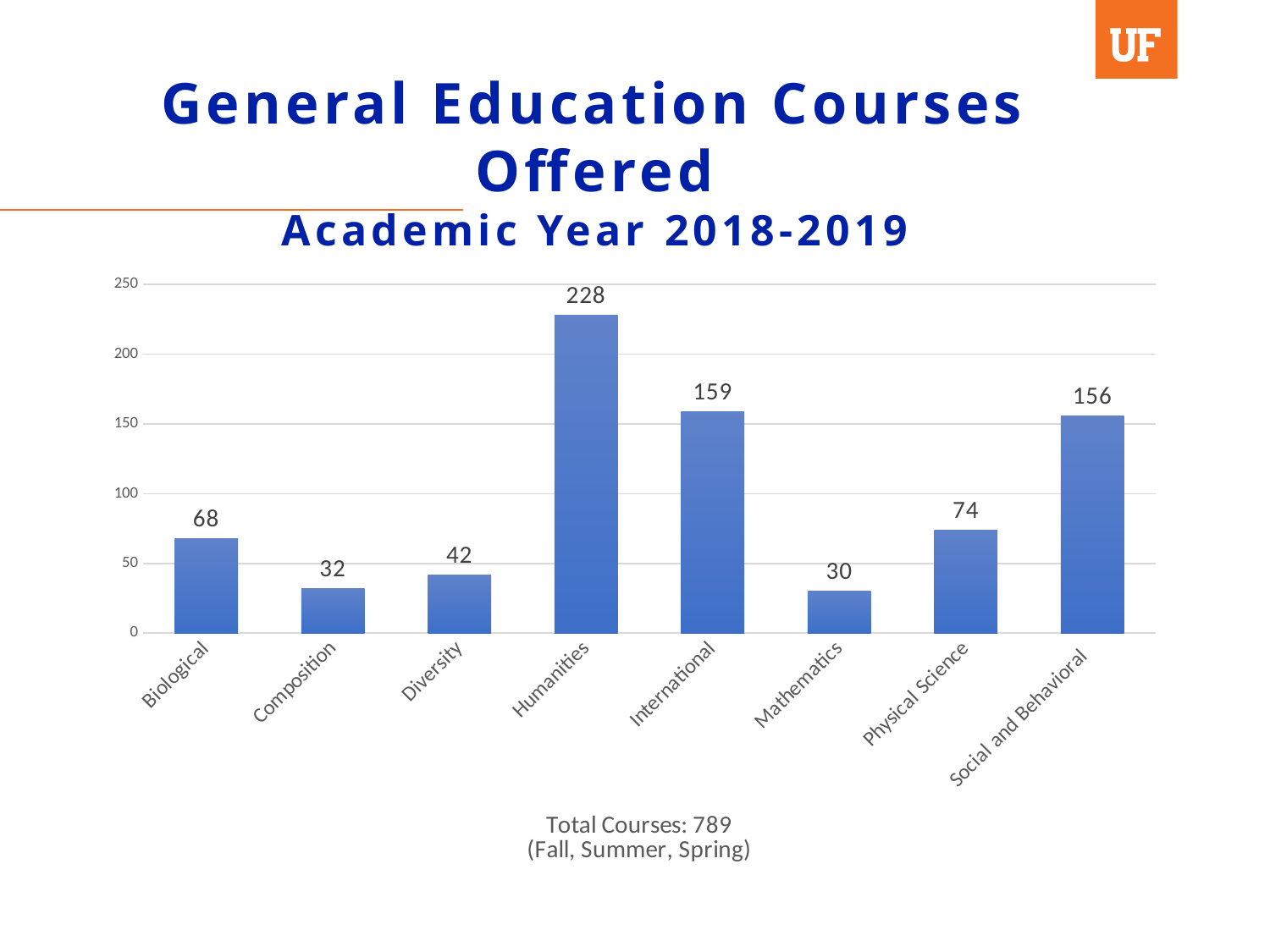
What is the difference between the number of courses in International and Social and Behavioral? 3 What kind of chart is shown on the slide? Bar chart How many courses were offered in Composition? 32 How many more courses were offered in Humanities than in Biological? 160 Is the value for Biological greater or less than 50? greater What is the value for Physical Science? 74 How many general education courses were offered in Humanities? 228 What total number of courses is stated below the chart? 789 Which has more courses offered, Diversity or Physical Science? Physical Science Which category has the highest number of courses offered? Humanities How many categories are shown on the chart? 8 Which category has the lowest number of courses offered? Mathematics